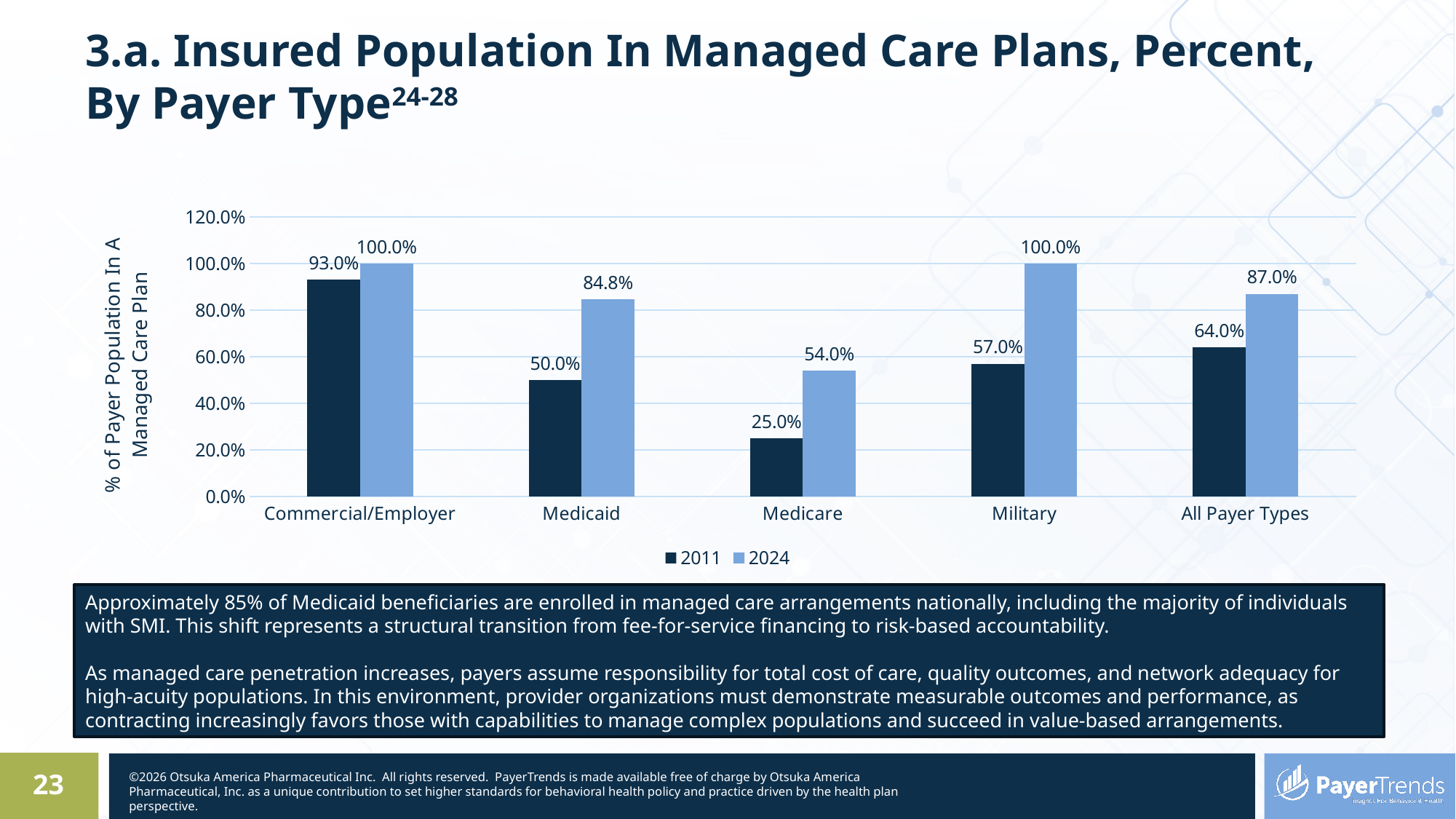
Which payer type has the lowest 2011 value? Medicare What is the difference between the 2024 and 2011 values for Medicaid? 34.8% How many series does the legend list? 2 What is the difference between the 2024 and 2011 values for Military? 43.0% Which is larger, the 2011 value for All Payer Types or the 2024 value for Medicare? 2011 value for All Payer Types How many payer type categories are shown on the x axis? 5 Which payer type has the highest 2011 value? Commercial/Employer What kind of chart is shown on the slide? Bar chart What is the 2011 value for Military? 57.0% What is the 2011 value for Medicare? 25.0% What is the 2024 value for Medicaid? 84.8% What is the 2024 value for All Payer Types? 87.0%